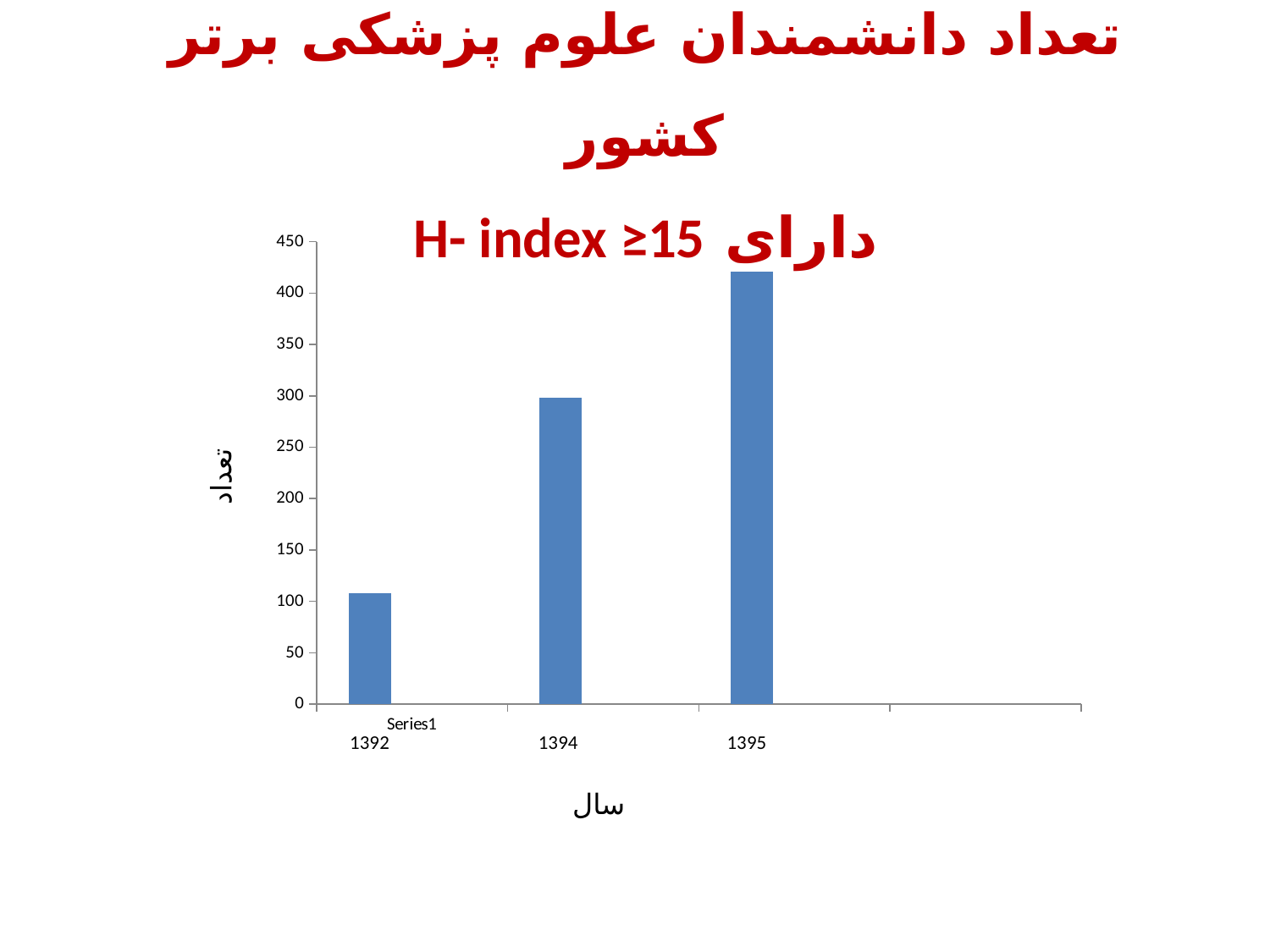
Which year has the larger value, 1392 or 1394? 1394 Which year has the lowest value in the chart? 1392 Is the value for 1395 greater or less than 400? greater What is the label of the y axis? تعداد What is the label of the x axis? سال Do the values rise or fall from 1392 to 1395 along the x axis? rise What kind of chart is shown on the slide? bar chart Which year has the highest value in the chart? 1395 Which year has the larger value, 1394 or 1395? 1395 How many bars (years) are plotted in the chart? 3 Is the value for 1394 greater or less than 250? greater Is the value for 1392 greater or less than 150? less